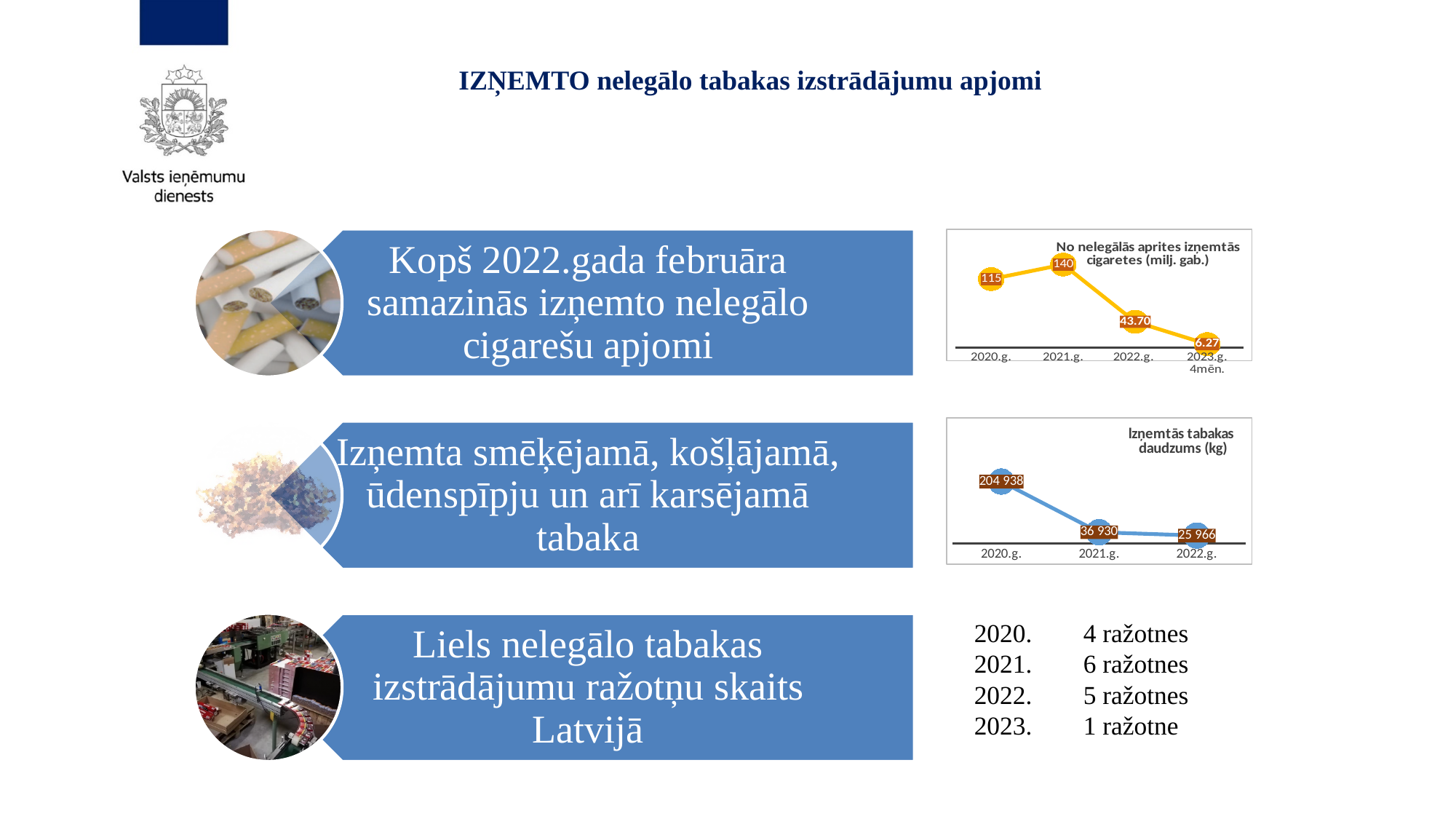
In the chart 'No nelegālās aprites izņemtās cigaretes (milj. gab.)', which category has the lowest value? 2023.g. 4mēn. In the chart 'No nelegālās aprites izņemtās cigaretes (milj. gab.)', what is the value for 2021.g.? 140 In the chart 'No nelegālās aprites izņemtās cigaretes (milj. gab.)', how many data points are plotted? 4 In the chart 'Izņemtās tabakas daudzums (kg)', what is the value for 2020.g.? 204 938 In the chart 'Izņemtās tabakas daudzums (kg)', which is larger, the value for 2021.g. or 2022.g.? 2021.g. In the chart 'Izņemtās tabakas daudzums (kg)', how many years are shown on the x axis? 3 In the chart 'Izņemtās tabakas daudzums (kg)', what is the value for 2022.g.? 25 966 What type of chart is 'No nelegālās aprites izņemtās cigaretes (milj. gab.)'? Line chart In the chart 'Izņemtās tabakas daudzums (kg)', do the values rise or fall from 2020.g. to 2022.g.? Fall In the chart 'No nelegālās aprites izņemtās cigaretes (milj. gab.)', what is the difference between the values for 2021.g. and 2020.g.? 25 In the chart 'No nelegālās aprites izņemtās cigaretes (milj. gab.)', what is the value for 2023.g. 4mēn.? 6.27 In the chart 'No nelegālās aprites izņemtās cigaretes (milj. gab.)', which year has the highest value? 2021.g.